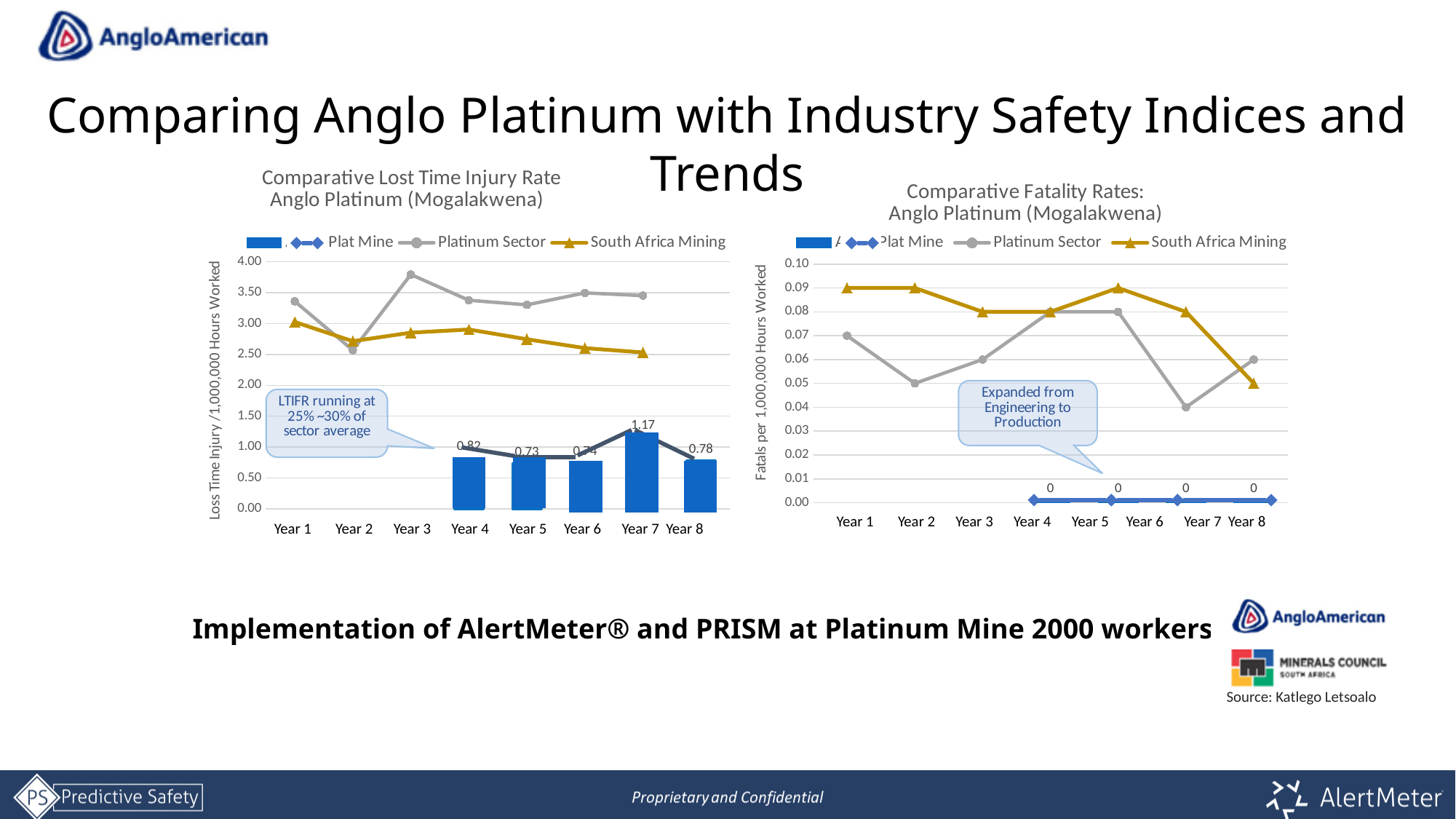
On the Comparative Lost Time Injury Rate chart, is the Platinum Sector value at Year 3 greater or less than 3.50? greater On the Comparative Fatality Rates chart, which series is higher at Year 1, Platinum Sector or South Africa Mining? South Africa Mining On the Comparative Lost Time Injury Rate chart, which bar is larger, Year 4 or Year 8? Year 4 On the Comparative Lost Time Injury Rate chart, how many bars are plotted? 5 On the Comparative Lost Time Injury Rate chart, what is the value of the bar for Year 7? 1.17 On the Comparative Lost Time Injury Rate chart, what is the value of the bar for Year 5? 0.73 On the Comparative Lost Time Injury Rate chart, which year has the lowest bar? Year 5 On the Comparative Fatality Rates chart, is the South Africa Mining value at Year 1 greater or less than 0.08? greater On the Comparative Lost Time Injury Rate chart, what is the difference between the Year 7 bar and the Year 4 bar? 0.35 What is the y-axis title of the Comparative Fatality Rates chart? Fatals per 1,000,000 Hours Worked On the Comparative Lost Time Injury Rate chart, which year has the highest bar? Year 7 On the Comparative Fatality Rates chart, what value is shown in the data labels for the Plat Mine series? 0